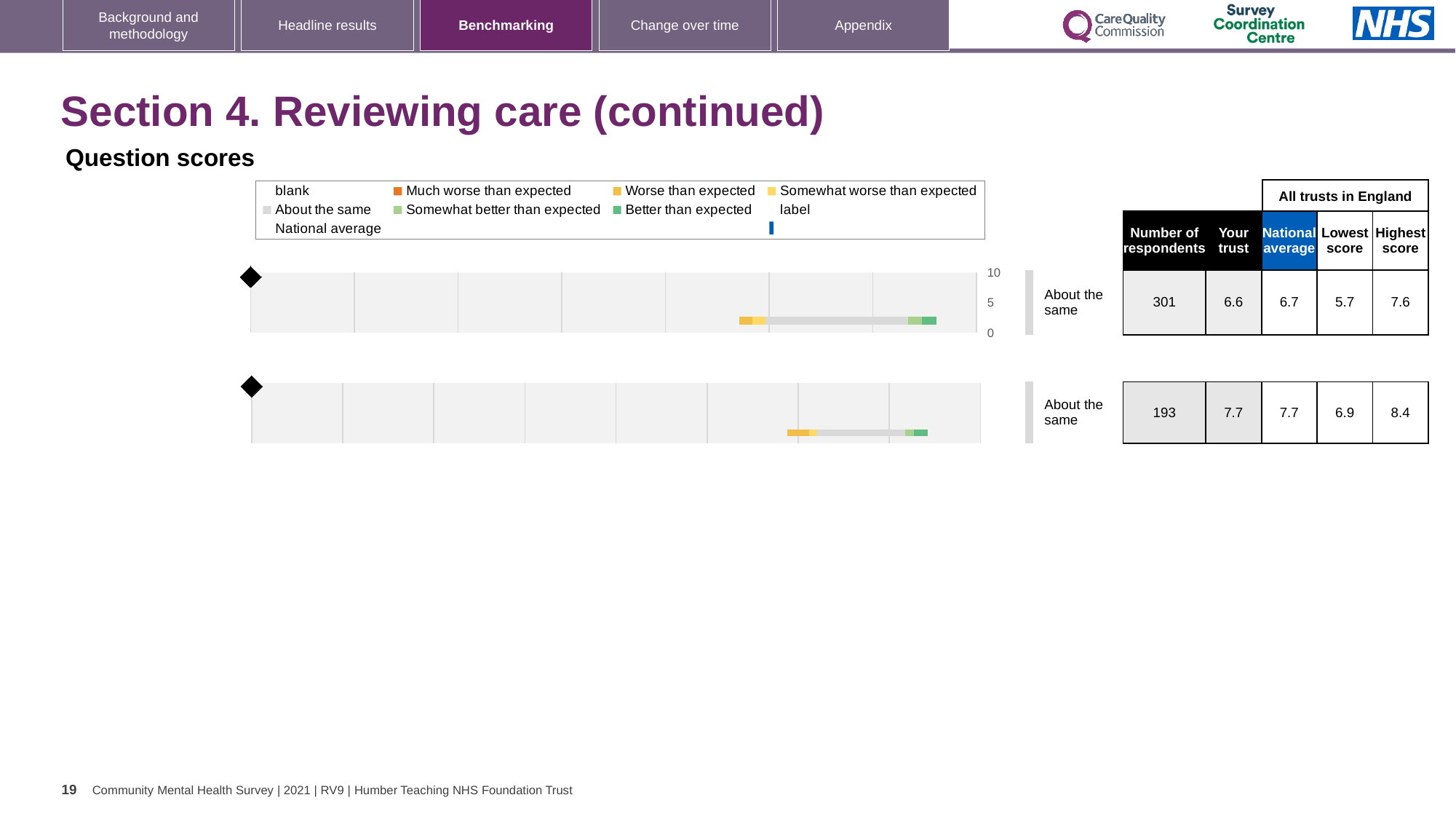
For the second (bottom) chart, what is the lowest score among all trusts in England? 6.9 For the second (bottom) chart, what is the difference between the highest score and the lowest score? 1.5 For the second (bottom) chart, what is the highest score among all trusts in England? 8.4 What benchmark category is given for the second (bottom) chart? About the same What kind of chart is used to show the question scores on this slide? bar chart What is the maximum value shown on the score axis of the charts? 10 For the first (top) chart, how many respondents are listed? 301 For the first (top) chart, which is larger: the 'Your trust' score or the national average? National average For the first (top) chart, what is the 'Your trust' score shown in the table? 6.6 For the first (top) chart, what is the national average score? 6.7 For the first (top) chart, what is the difference between the highest score and the lowest score? 1.9 How many question score charts are shown on the slide? 2